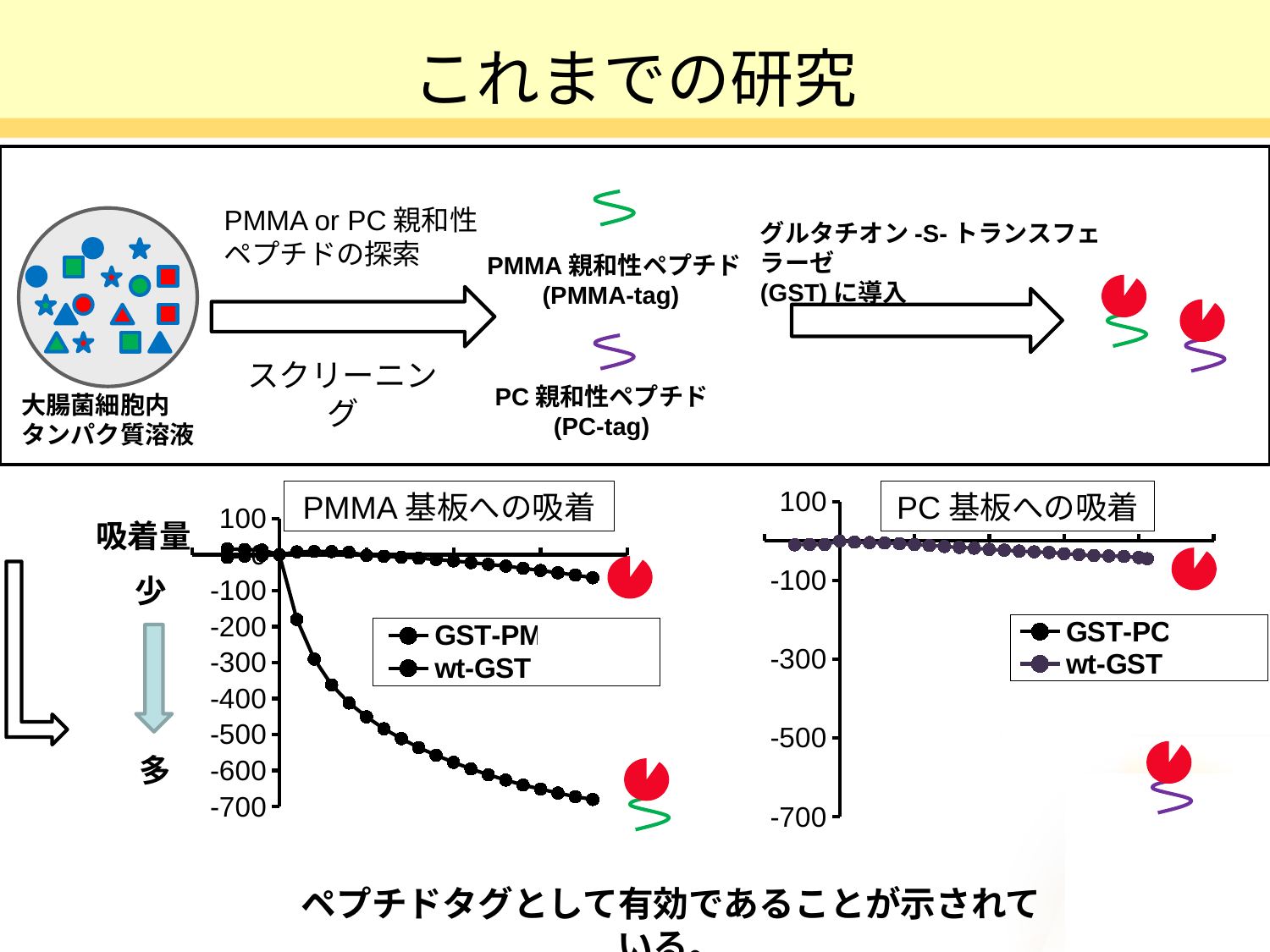
In the "PMMA 基板への吸着" chart, is the final value of the upper, nearly flat series greater or less than -100? greater What is the lowest tick value shown on the y axis of the "PMMA 基板への吸着" chart? -700 What kind of chart is the "PMMA 基板への吸着" chart on the left? line chart Which chart reaches a lower (more negative) value at the end of the x axis, "PMMA 基板への吸着" or "PC 基板への吸着"? PMMA 基板への吸着 What are the two legend entries of the "PC 基板への吸着" chart? GST-PC and wt-GST In the "PC 基板への吸着" chart, do the plotted values rise or fall along the x axis? fall In the "PC 基板への吸着" chart, is the final plotted value greater or less than -100? greater In the "PMMA 基板への吸着" chart, do the values of the steeply falling series rise or fall along the x axis? fall How many series does the legend of the "PMMA 基板への吸着" chart list? 2 In the "PMMA 基板への吸着" chart, is the final value of the steeply falling series greater or less than -600? less How many series does the legend of the "PC 基板への吸着" chart list? 2 What kind of chart is the "PC 基板への吸着" chart on the right? line chart